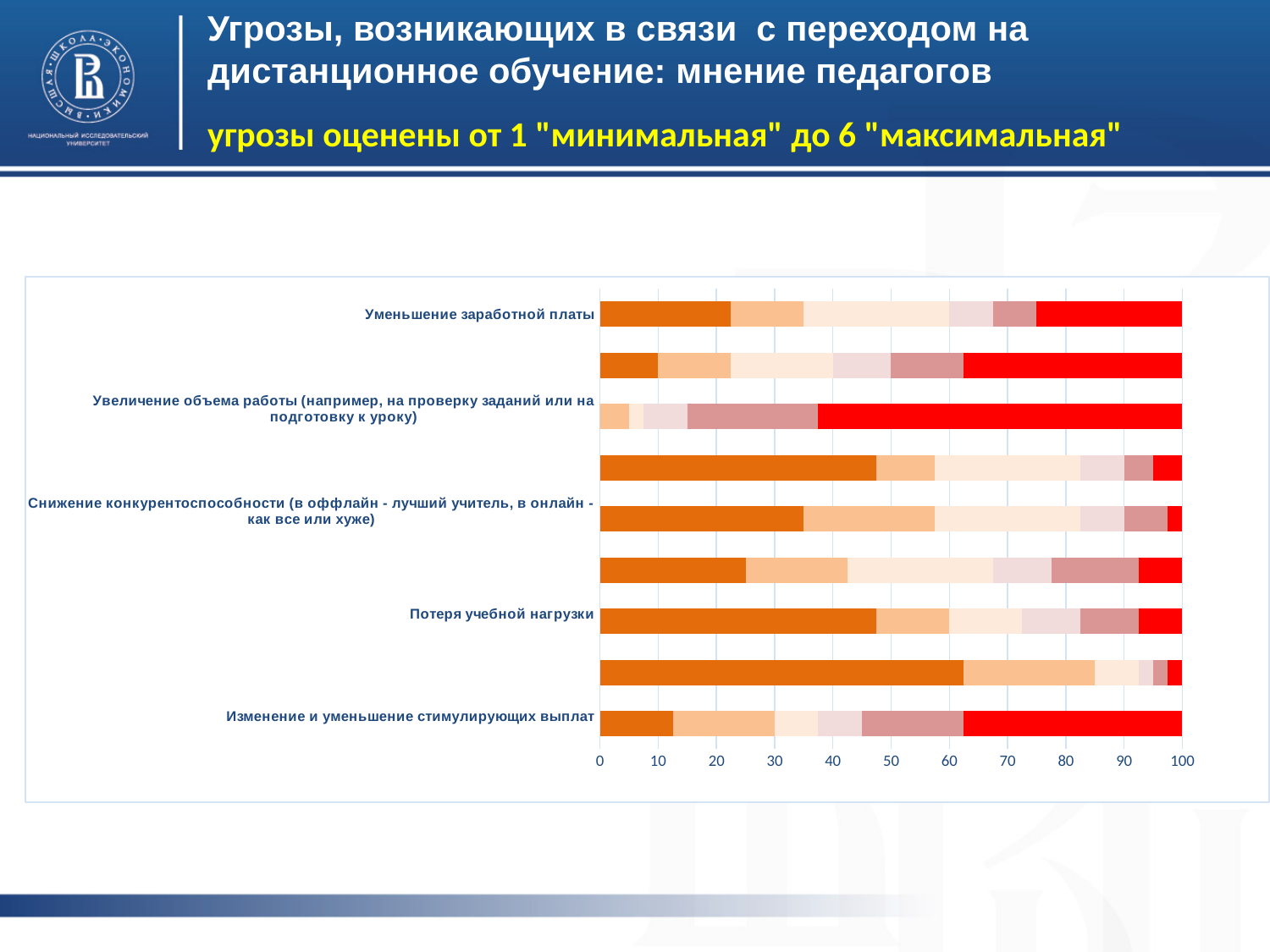
How many bars are plotted in the chart? 9 Which has the longer first (dark orange) segment: "Потеря учебной нагрузки" or "Уменьшение заработной платы"? Потеря учебной нагрузки What is the highest value shown on the horizontal axis of the chart? 100 What kind of chart is shown on the slide? Stacked bar chart Is the first (dark orange) segment of the bar for "Уменьшение заработной платы" greater or less than 30? less What is the total length of the stacked bar for "Уменьшение заработной платы"? 100 Is the first (dark orange) segment of the bar for "Снижение конкурентоспособности (в оффлайн - лучший учитель, в онлайн - как все или хуже)" greater or less than 30? greater Is the red (last) segment of the bar for "Увеличение объема работы (например, на проверку заданий или на подготовку к уроку)" greater or less than 50? greater Are the bars in the chart drawn horizontally or vertically? Horizontally